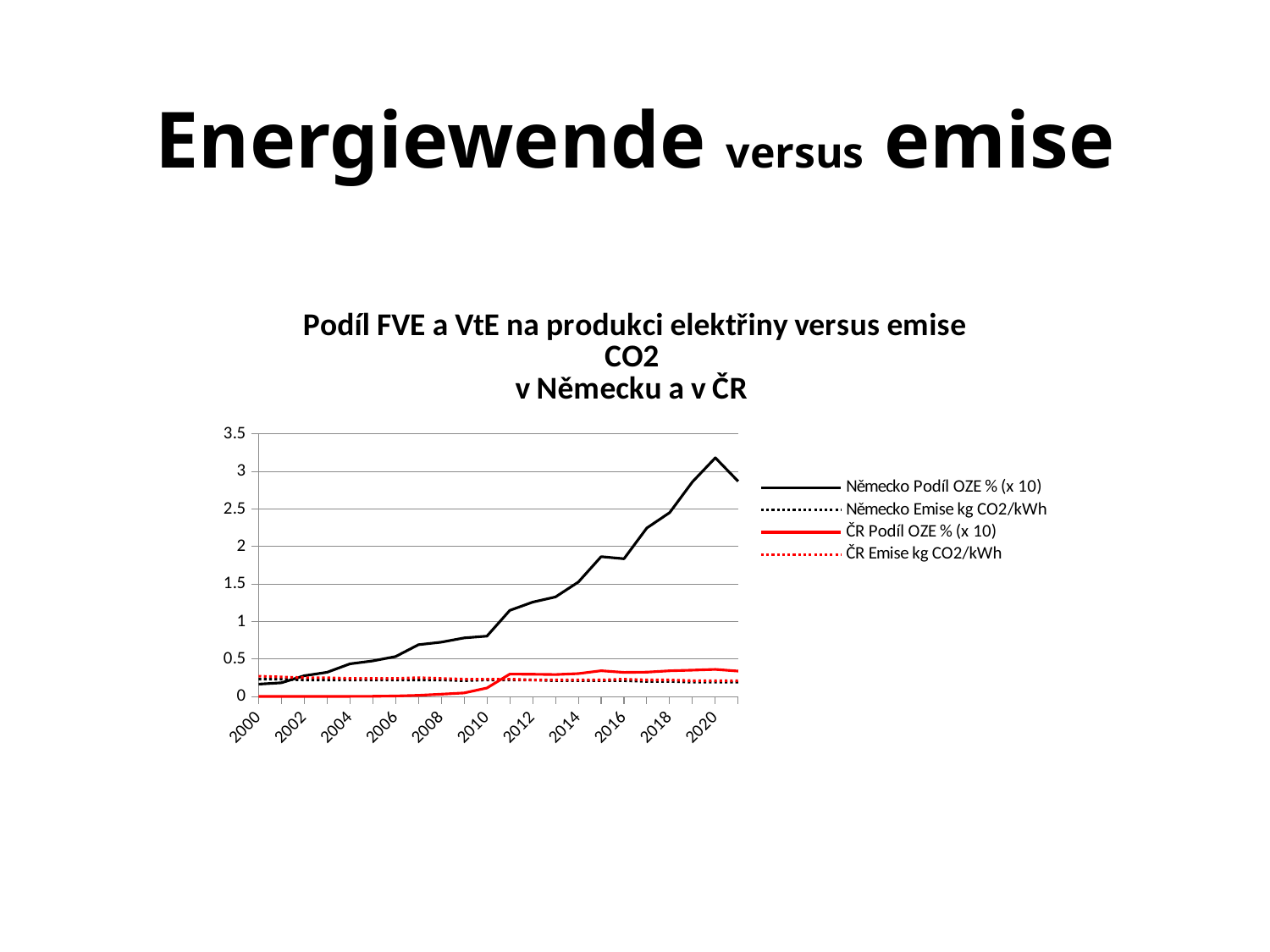
In which year is the Německo Podíl OZE % (x 10) series at its lowest value? 2000 Is the value of Německo Podíl OZE % (x 10) in 2020 greater or less than 3? greater How many series does the legend list? 4 In 2020, which is larger: Německo Podíl OZE % (x 10) or ČR Podíl OZE % (x 10)? Německo Podíl OZE % (x 10) What is the title of the chart? Podíl FVE a VtE na produkci elektřiny versus emise CO2 v Německu a v ČR What kind of chart is shown on the slide? line chart Which series is drawn as a solid red line? ČR Podíl OZE % (x 10) In which year does the Německo Podíl OZE % (x 10) series reach its highest value? 2020 Is the value of Německo Podíl OZE % (x 10) in 2018 greater or less than 2? greater Is the value of ČR Podíl OZE % (x 10) in 2020 greater or less than 0.5? less Does the Německo Podíl OZE % (x 10) series generally rise or fall from 2000 to 2020? rise